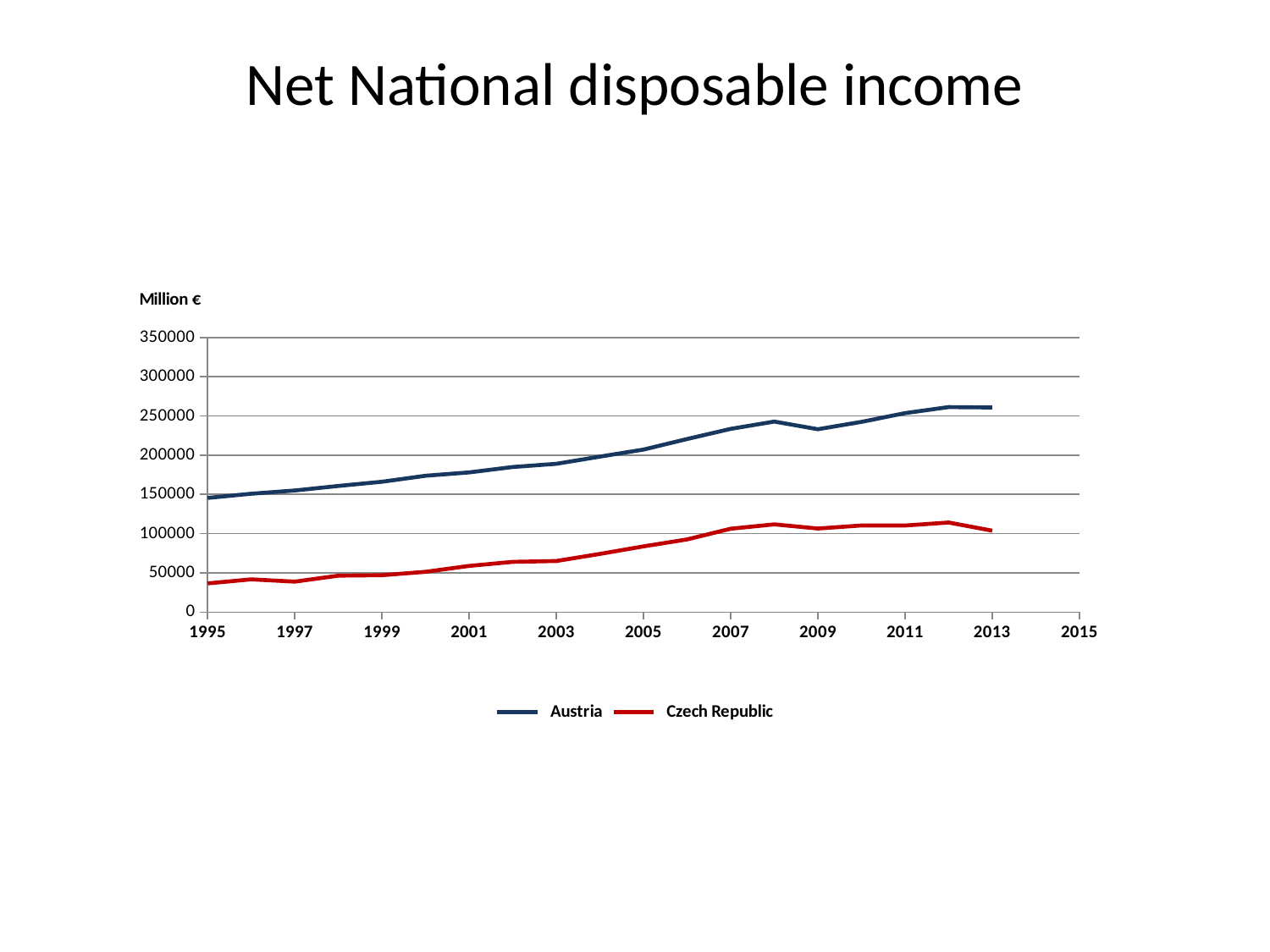
Which series has the higher value in 2013, Austria or Czech Republic? Austria Is the value for Austria in 2013 greater or less than 250000? greater Is the value for Czech Republic in 2003 greater or less than 50000? greater How many series does the legend list? 2 What kind of chart is shown on the slide? line chart Is the value for Austria in 2007 greater or less than 200000? greater In which year is the Austria series at its lowest? 1995 Does the Czech Republic line generally rise or fall from 1995 to 2007? rise What is the title of the chart? Net National disposable income What unit is shown above the vertical axis? Million € Does the Austria line generally rise or fall from 1995 to 2013? rise